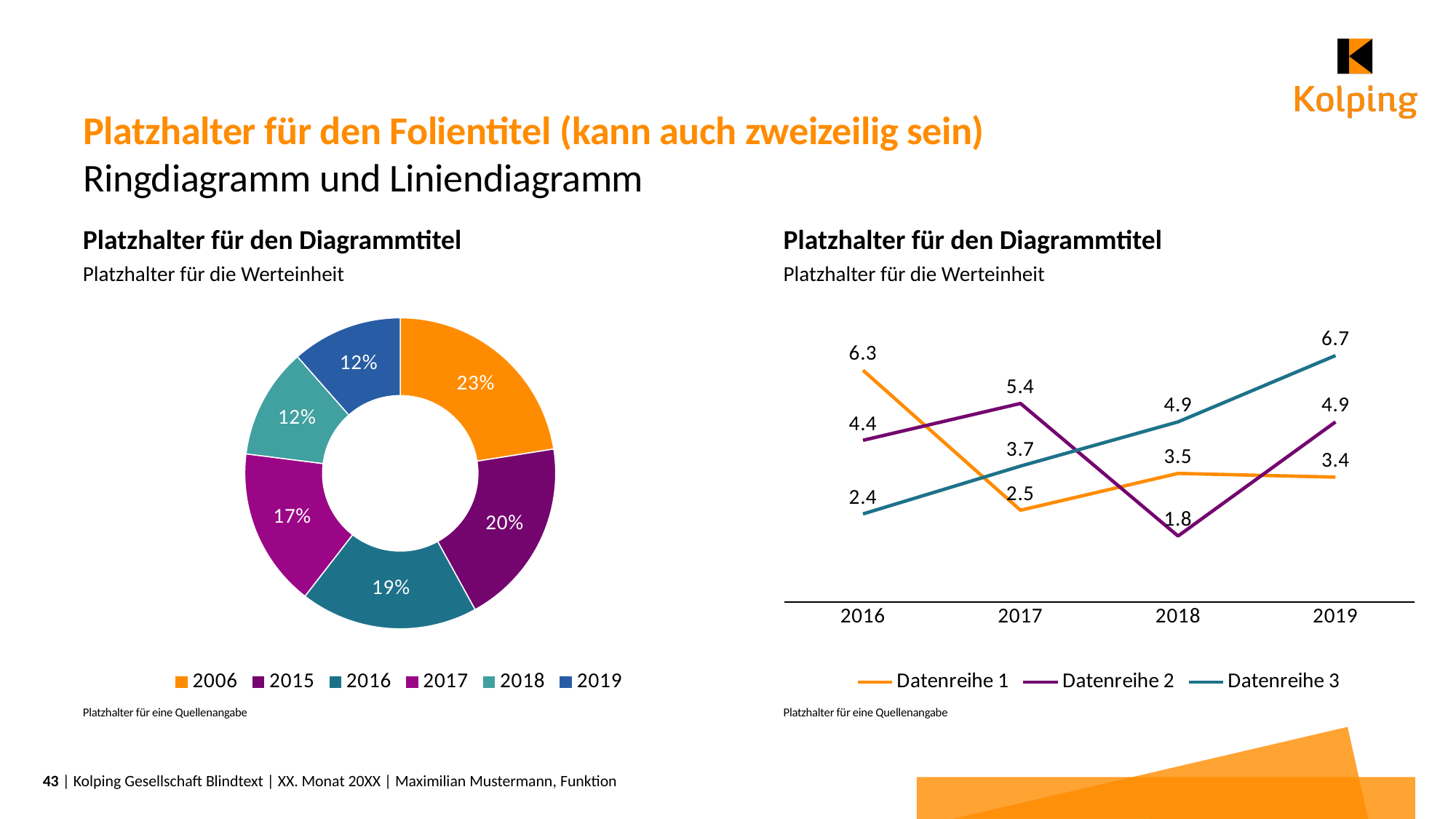
In the right chart, what is the difference between Datenreihe 1 and Datenreihe 3 in 2016? 3.9 In the left chart, how many categories does the legend list? 6 In the right chart, what is the value of Datenreihe 3 in 2019? 6.7 In the right chart, does Datenreihe 3 rise or fall from 2016 to 2019? rise In the right chart, how many series does the legend list? 3 In the right chart, is the value of Datenreihe 2 in 2017 larger or smaller than the value of Datenreihe 3 in 2017? larger In the right chart, what is the value of Datenreihe 2 in 2018? 1.8 In the left chart, which category has the largest share? 2006 In the left chart, what is the difference between the shares of 2015 and 2017? 3% In the left chart, what share does 2006 have? 23% In the right chart, which series has the highest value in 2016? Datenreihe 1 What kind of chart is the left chart? Donut chart